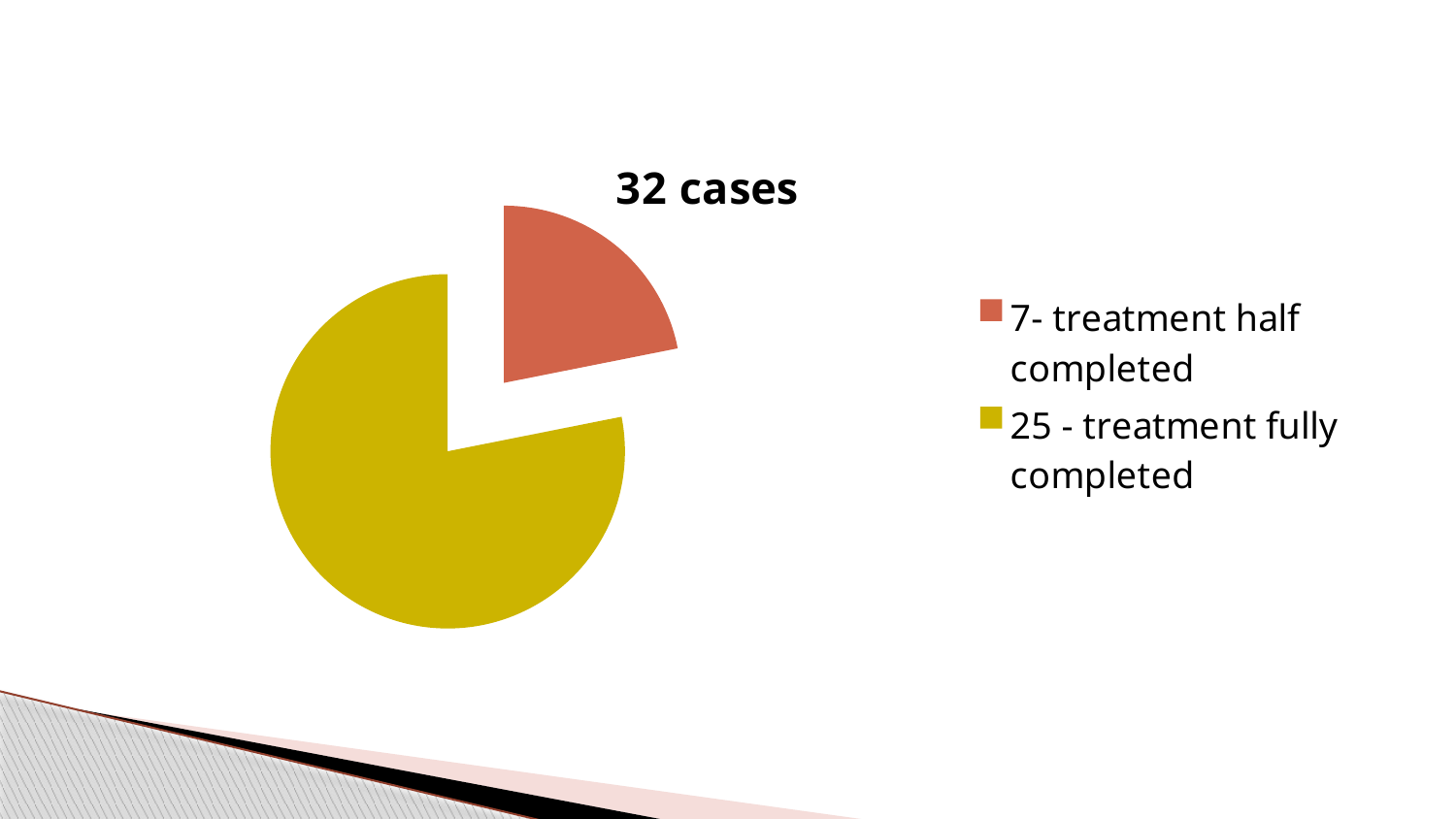
What colour is the slice for treatment fully completed? yellow How many cases had treatment half completed? 7 What is the difference between the number of cases with treatment fully completed and those with treatment half completed? 18 Which category has the smallest slice of the pie? treatment half completed How many slices does the pie chart have? 2 Which category has the largest slice of the pie? treatment fully completed How many cases had treatment fully completed? 25 What is the title of the pie chart? 32 cases How many entries does the legend list? 2 What kind of chart is shown on the slide? pie chart Which is larger: the number of cases with treatment half completed or with treatment fully completed? treatment fully completed What is the total number of cases represented in the pie chart? 32